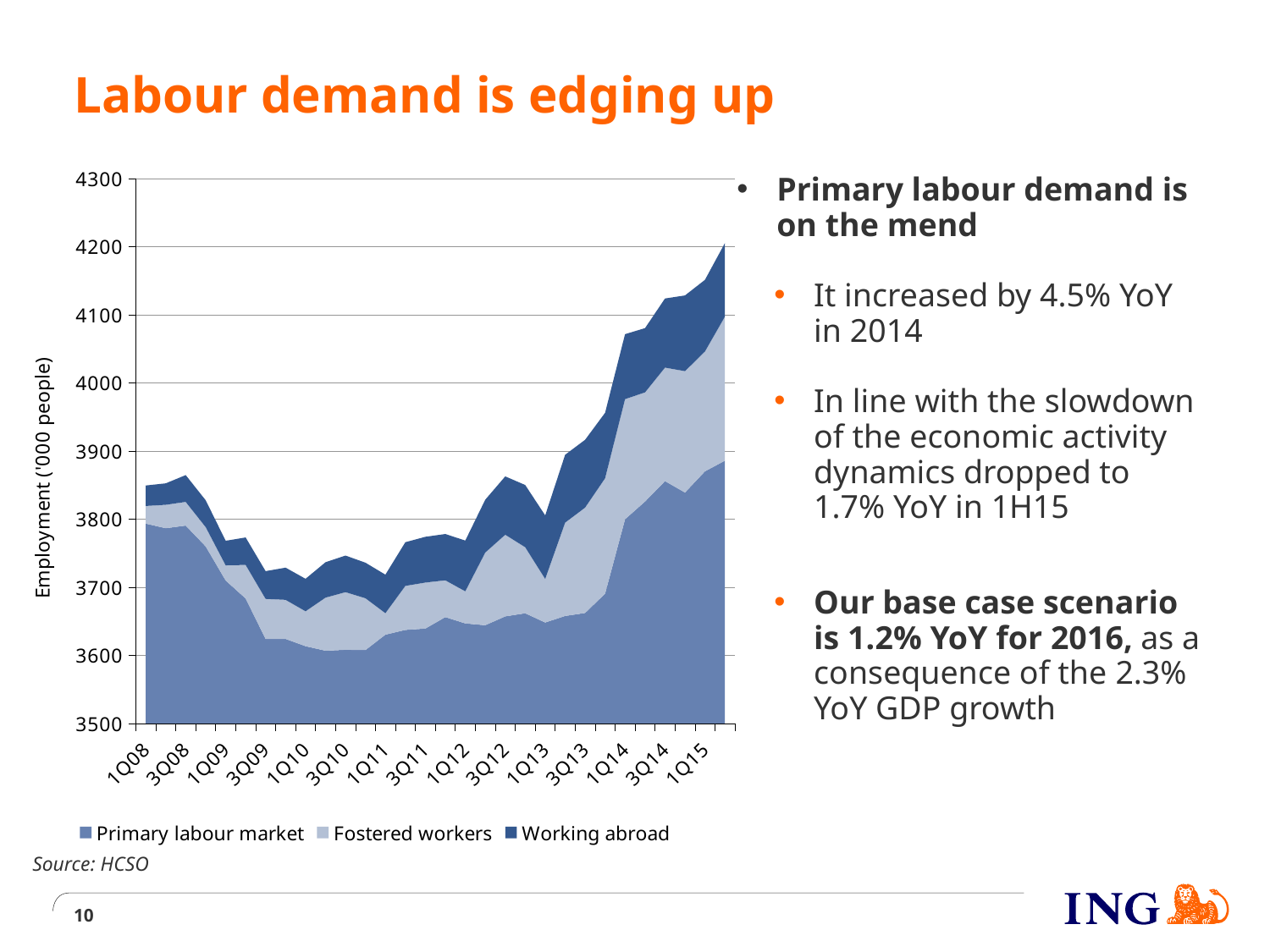
Does total employment rise or fall between 1Q14 and 1Q15? rise Is the total employment at 1Q10 greater or less than 3800? less Is the total employment at 1Q15 greater or less than 4100? greater Is the value for Primary labour market at 3Q10 greater or less than 3700? less What kind of chart is shown on the slide? Stacked area chart How many series does the chart legend list? 3 Does total employment rise or fall between 1Q08 and 1Q10? fall What is the label of the vertical axis of the chart? Employment ('000 people) How many quarter labels are shown on the x axis of the chart? 15 What are the three series listed in the chart legend? Primary labour market, Fostered workers, Working abroad